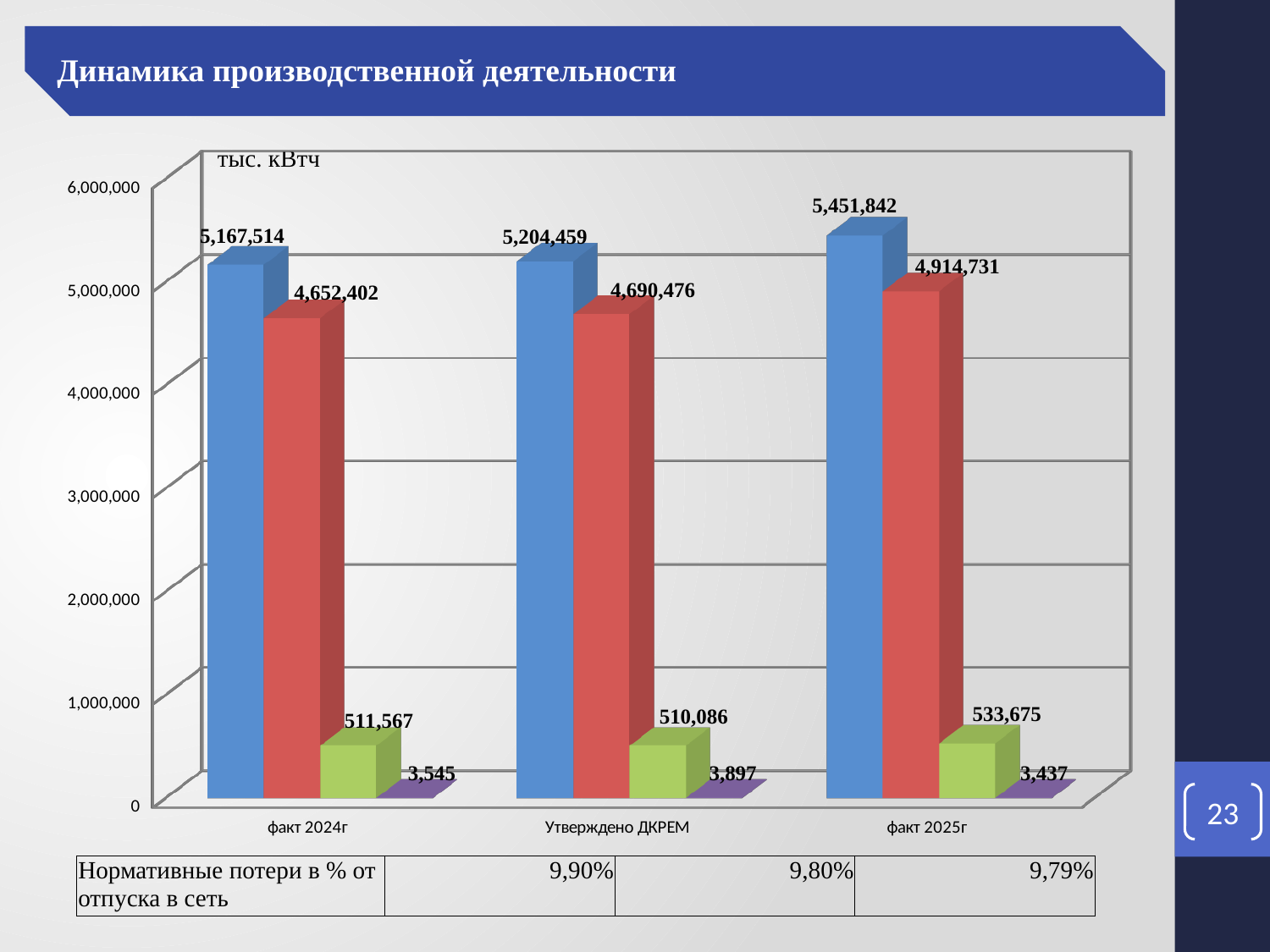
How many categories are shown on the x axis? 3 What unit is shown at the top of the chart's value axis? тыс. кВтч What is the value of the green bar for факт 2024г? 511,567 What is the value of the blue bar for факт 2025г? 5,451,842 What is the value of the purple bar for Утверждено ДКРЕМ? 3,897 Which category has the lowest purple bar? факт 2025г Which is larger: the green bar for факт 2024г or the green bar for Утверждено ДКРЕМ? факт 2024г Which category has the highest blue bar? факт 2025г What kind of chart is shown on the slide? Bar chart Do the blue bar values rise or fall from факт 2024г to факт 2025г? Rise What is the difference between the blue bar values for факт 2025г and факт 2024г? 284,328 What is the value of the red bar for Утверждено ДКРЕМ? 4,690,476